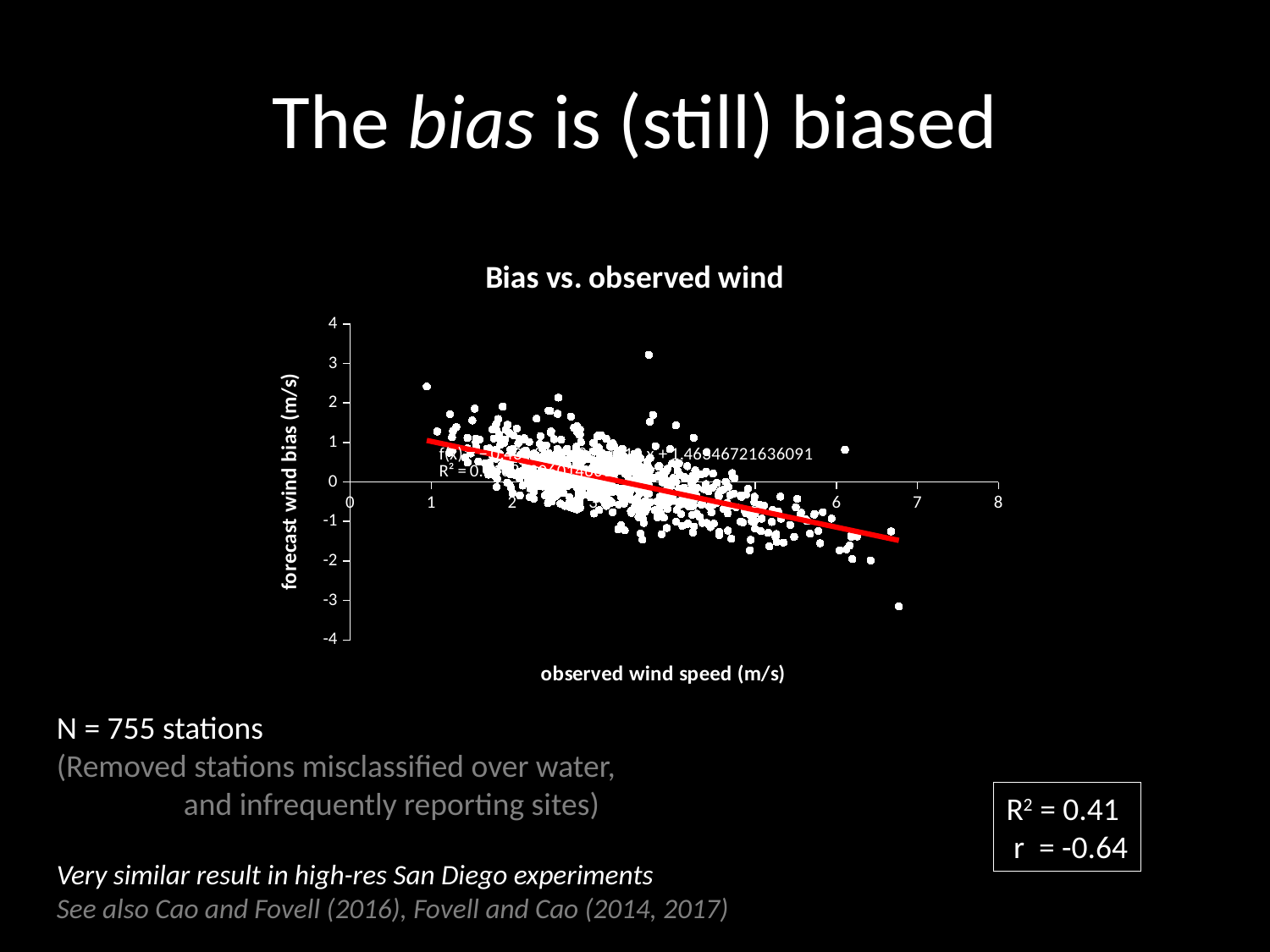
What is the maximum value shown on the y axis of the chart? 4 What kind of chart is shown on the slide? scatter chart What is the maximum value shown on the x axis of the chart? 8 Is the lowest plotted point's forecast wind bias greater or less than -3? less How many tick labels are shown on the x axis of the chart? 9 What is the label of the x axis of the chart? observed wind speed (m/s) Is the highest plotted point's forecast wind bias greater or less than 3? greater As observed wind speed increases along the x axis, does the forecast wind bias generally rise or fall? fall Is the red trend line's value at an observed wind speed of 1 m/s greater or less than 0? greater What is the title of the chart? Bias vs. observed wind